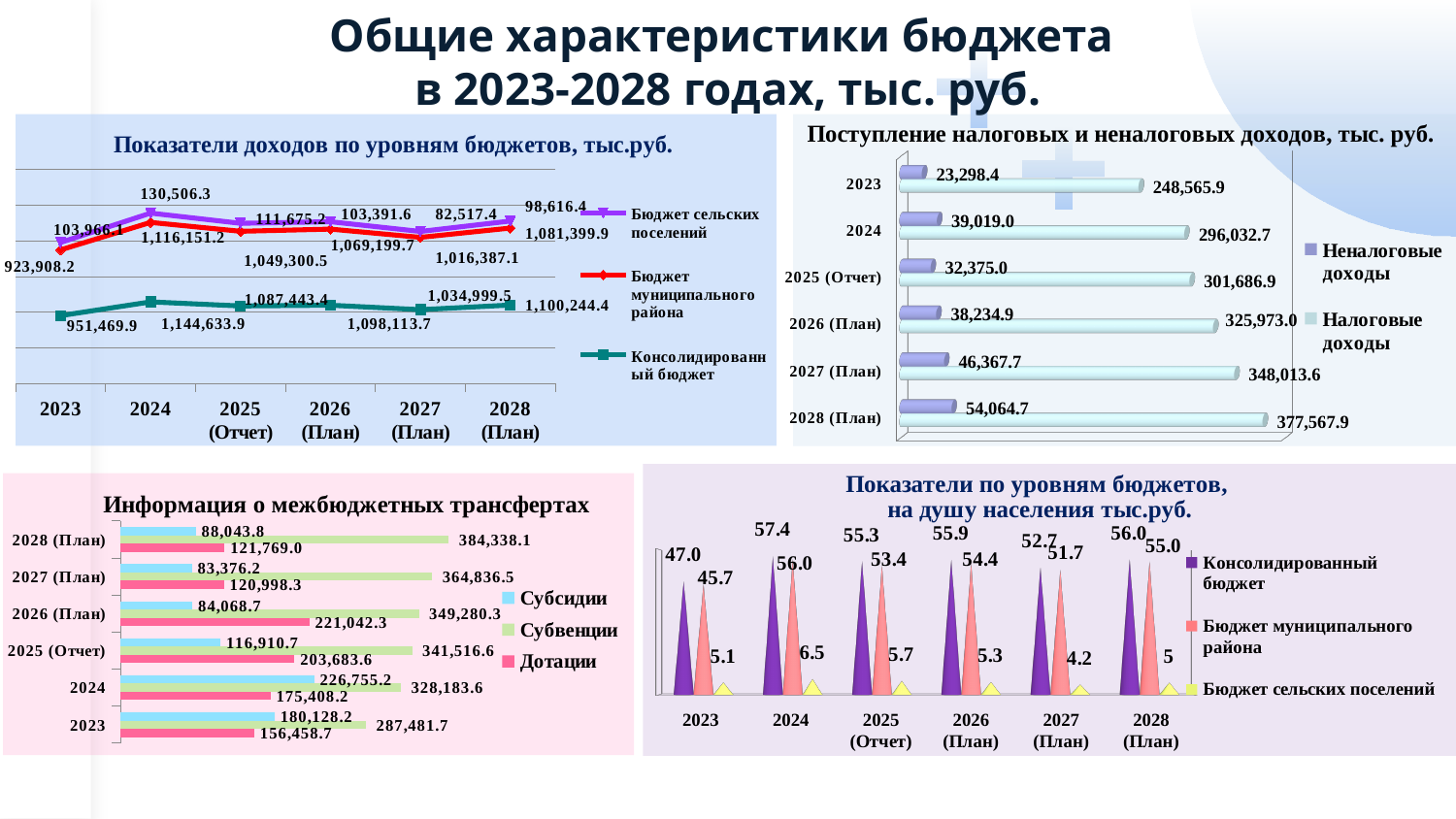
In the chart 'Показатели доходов по уровням бюджетов, тыс.руб.', in which year is the value for Бюджет сельских поселений the lowest? 2027 (План) What type of chart is 'Информация о межбюджетных трансфертах'? Bar chart In the chart 'Показатели по уровням бюджетов, на душу населения тыс.руб.', what is the value for Консолидированный бюджет in 2024? 57.4 In the chart 'Показатели по уровням бюджетов, на душу населения тыс.руб.', how many years are shown on the x axis? 6 In the chart 'Поступление налоговых и неналоговых доходов, тыс. руб.', what is the difference between Налоговые доходы in 2024 and in 2023? 47,466.8 In the chart 'Информация о межбюджетных трансфертах', what is the value of Субвенции for 2026 (План)? 349,280.3 In the chart 'Показатели доходов по уровням бюджетов, тыс.руб.', what is the value for Бюджет сельских поселений in 2024? 130,506.3 In the chart 'Информация о межбюджетных трансфертах', which is larger for 2024: Субсидии or Дотации? Субсидии In the chart 'Показатели доходов по уровням бюджетов, тыс.руб.', how many series does the legend list? 3 In the chart 'Поступление налоговых и неналоговых доходов, тыс. руб.', which year has the lowest value of Неналоговые доходы? 2023 In the chart 'Поступление налоговых и неналоговых доходов, тыс. руб.', what is the value of Налоговые доходы for 2028 (План)? 377,567.9 In the chart 'Показатели по уровням бюджетов, на душу населения тыс.руб.', in which year is the value for Бюджет сельских поселений the highest? 2024